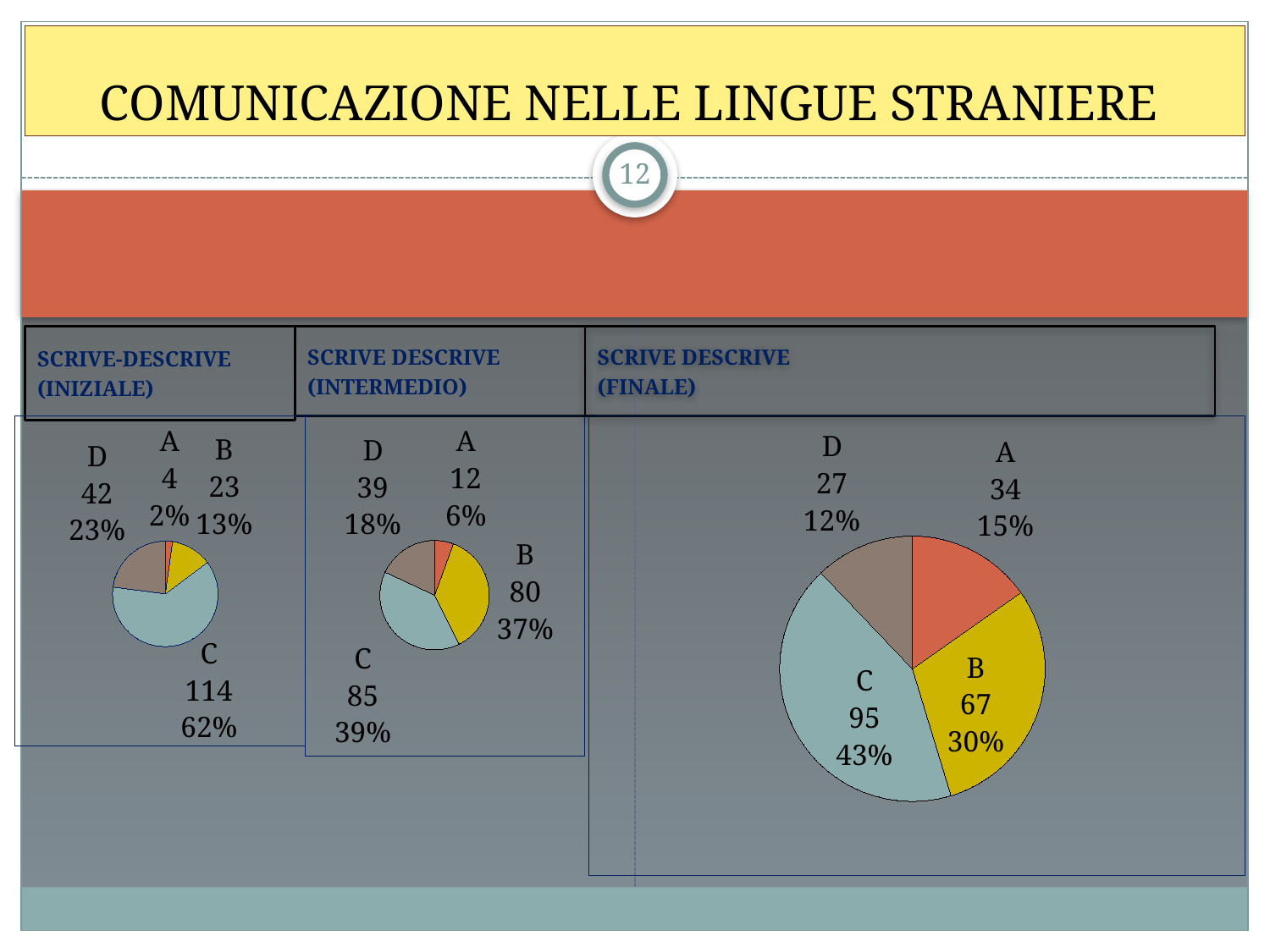
In the SCRIVE DESCRIVE (INTERMEDIO) chart, what percentage share does category A have? 6% In the SCRIVE DESCRIVE (INTERMEDIO) chart, what is the value for category B? 80 In the SCRIVE-DESCRIVE (INIZIALE) chart, what is the value for category C? 114 In the SCRIVE-DESCRIVE (INIZIALE) chart, what percentage share does category D have? 23% In the SCRIVE DESCRIVE (FINALE) chart, what percentage share does category C have? 43% In the SCRIVE DESCRIVE (FINALE) chart, which category is the largest? C In the SCRIVE-DESCRIVE (INIZIALE) chart, which category is the smallest? A What kind of chart is used for SCRIVE DESCRIVE (FINALE)? Pie chart In the SCRIVE DESCRIVE (FINALE) chart, which is larger, the value for B or the value for D? B How many categories does the SCRIVE DESCRIVE (FINALE) chart show? 4 In the SCRIVE DESCRIVE (INTERMEDIO) chart, what is the difference between the values for C and D? 46 In the SCRIVE DESCRIVE (FINALE) chart, what is the value for category A? 34